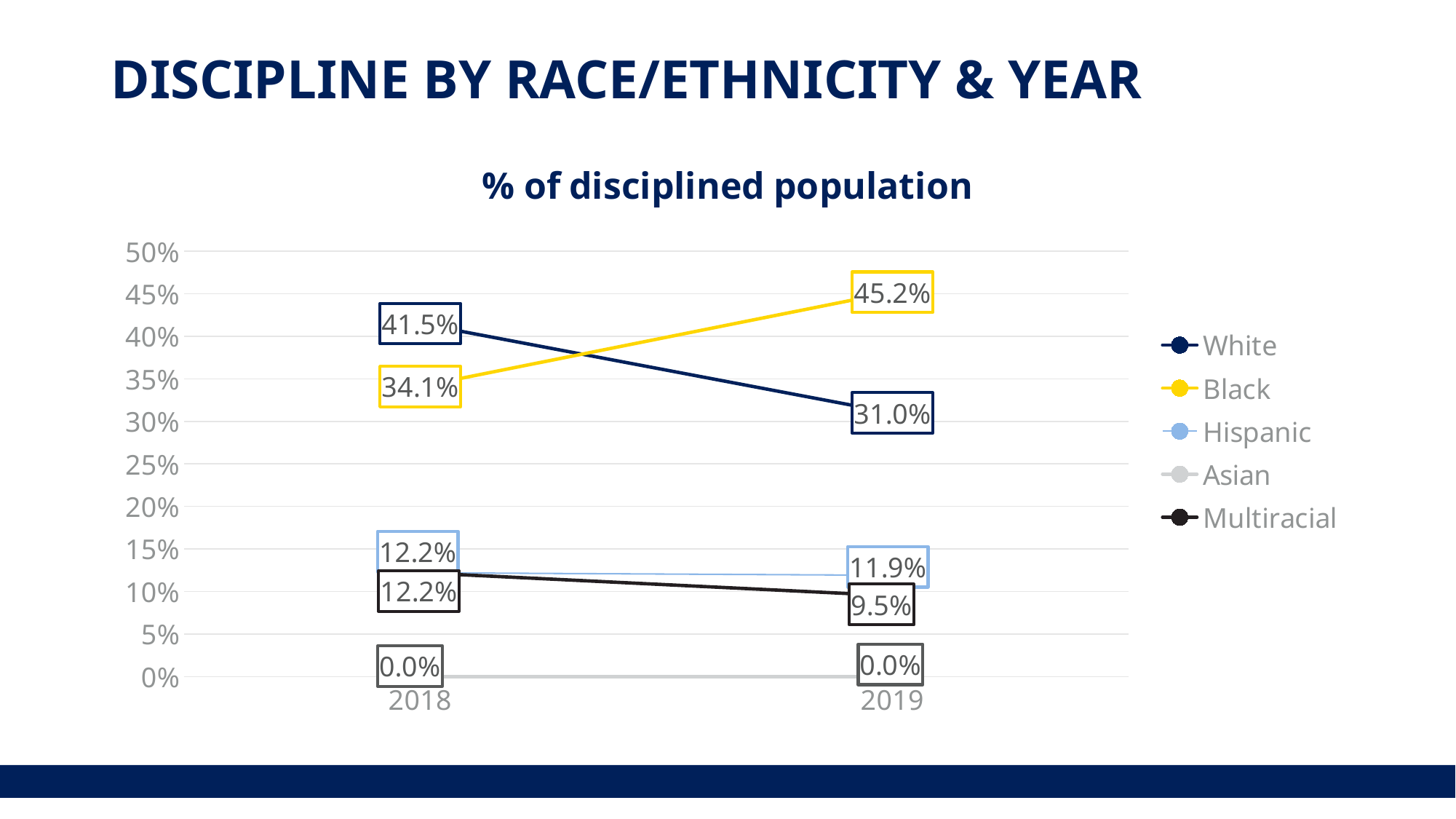
What is the value for Multiracial in 2019? 9.5% Does the value for Black rise or fall from 2018 to 2019? rise What type of chart is shown on the slide? line chart What is the value for Black in 2019? 45.2% Which series has the lowest value in 2018? Asian What is the value for White in 2018? 41.5% What is the title of the chart? % of disciplined population What is the difference between the White values in 2018 and 2019? 10.5% What is the value for Hispanic in 2019? 11.9% Which series has the highest value in 2019? Black Which is larger in 2018, the value for White or the value for Black? White How many series does the legend list? 5